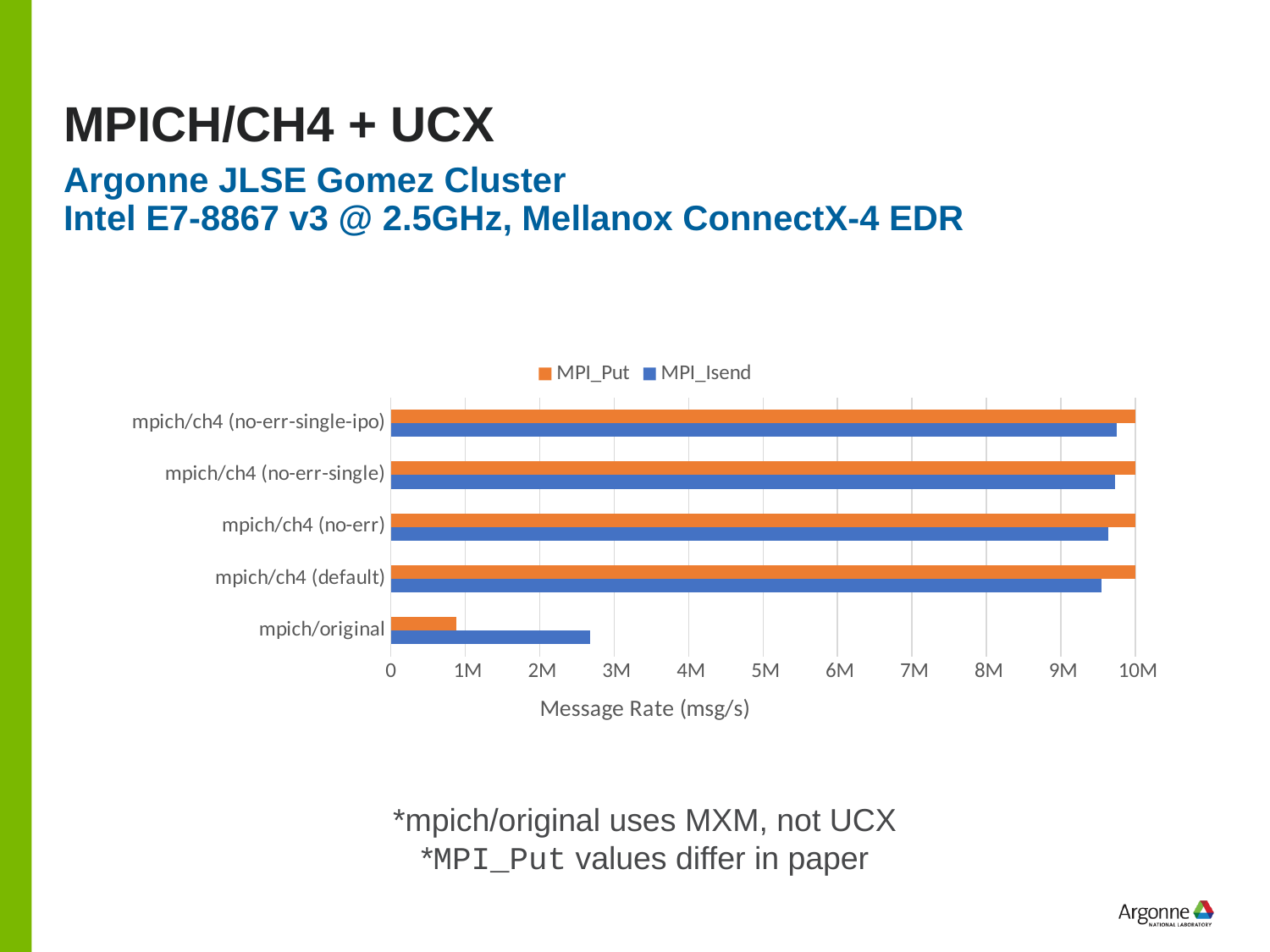
What kind of chart is shown on the slide? bar chart Is the MPI_Isend value for mpich/original greater or less than 2M? greater Which series is shown in orange? MPI_Put How many configurations (categories) are plotted on the chart? 5 Which configuration has the lowest MPI_Isend message rate? mpich/original For mpich/ch4 (default), which is larger: the MPI_Put value or the MPI_Isend value? MPI_Put For mpich/original, which is larger: the MPI_Put value or the MPI_Isend value? MPI_Isend What is the title of the horizontal axis? Message Rate (msg/s) Is the MPI_Isend value for mpich/ch4 (default) greater or less than 9M? greater Is the MPI_Put value for mpich/original greater or less than 1M? less How many series does the legend list? 2 Which configuration has the lowest MPI_Put message rate? mpich/original